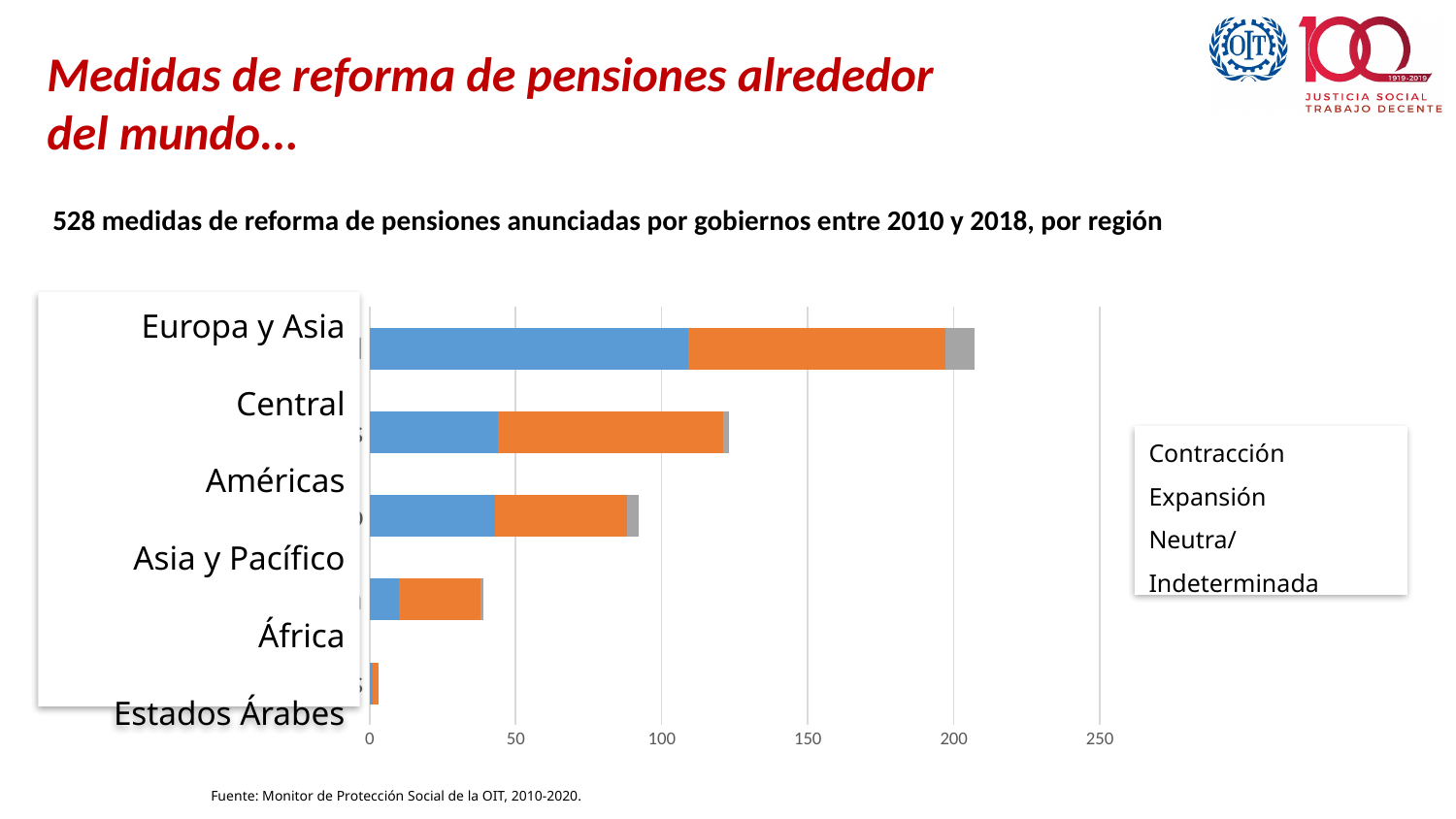
Is the total bar for África greater or less than 50? less Which region has the highest total number of pension reform measures? Europa y Asia Central What is the title of the chart? 528 medidas de reforma de pensiones anunciadas por gobiernos entre 2010 y 2018, por región How many series does the chart legend list? 3 Which region has a larger total bar, Américas or Asia y Pacífico? Américas Is the total bar for Europa y Asia Central greater or less than 200? greater Is the total bar for Asia y Pacífico greater or less than 100? less Which series is shown in orange in the chart? Expansión How many regions (categories) are plotted in the chart? 5 What kind of chart is shown on the slide? Stacked bar chart Which region has the lowest total number of pension reform measures? Estados Árabes